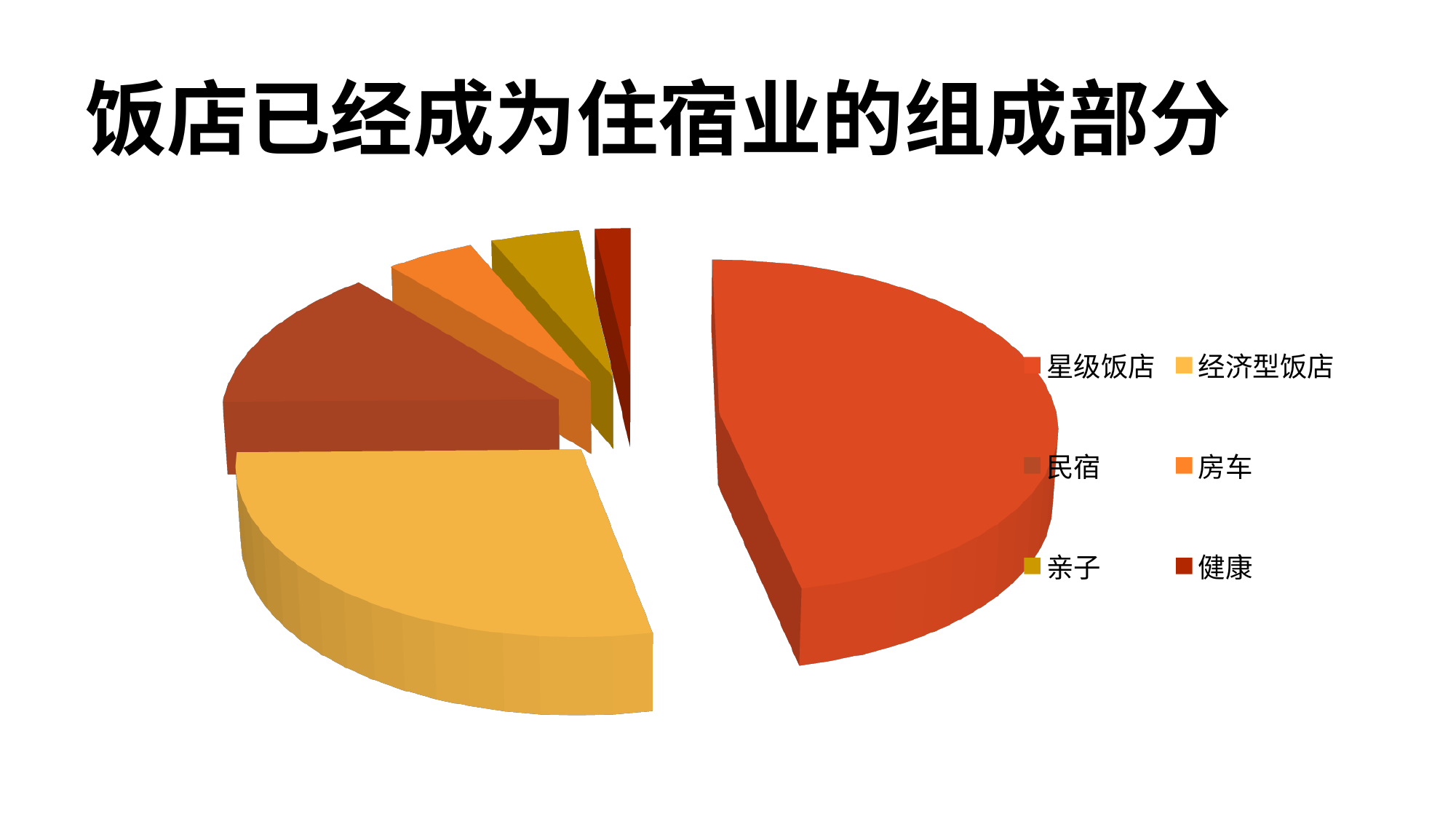
Which slice is larger, 亲子 or 健康? 亲子 How many categories does the pie chart show? 6 What kind of chart is shown on the slide? pie chart Which category is shown in the yellow slice of the pie chart? 经济型饭店 Which category has the largest slice of the pie chart? 星级饭店 What is the title of the slide containing the pie chart? 饭店已经成为住宿业的组成部分 Which category has the second-largest slice of the pie chart? 经济型饭店 Which slice is larger, 民宿 or 房车? 民宿 Which category has the smallest slice of the pie chart? 健康 Which slice is larger, 星级饭店 or 经济型饭店? 星级饭店